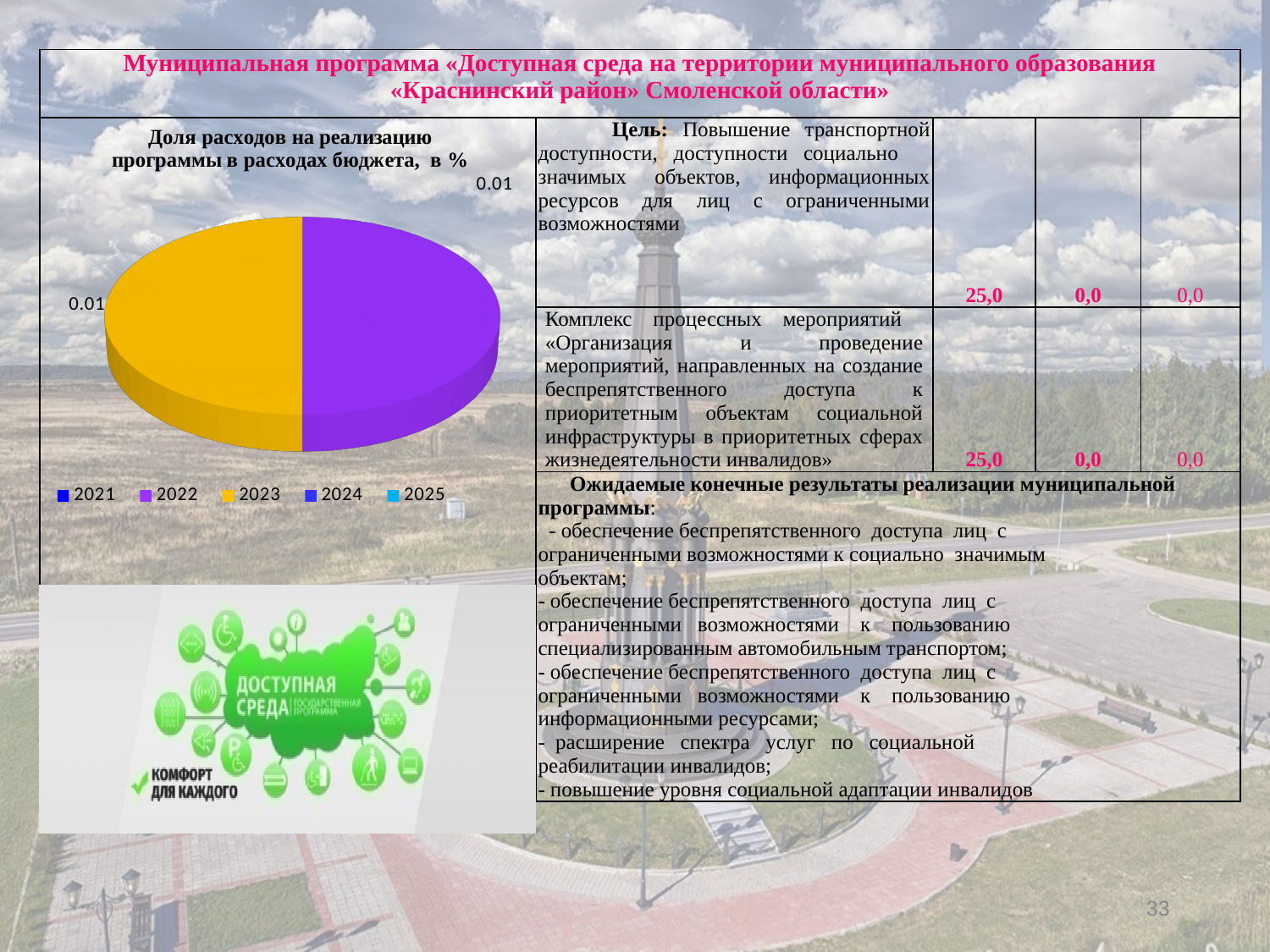
What value is labelled on the pie chart for 2022? 0.01 What value is labelled on the pie chart for 2023? 0.01 How many slices are visible in the pie chart? 2 Which years listed in the legend have no visible slice in the pie chart? 2021, 2024, 2025 What is the title of the pie chart? Доля расходов на реализацию программы в расходах бюджета, в % How many entries does the legend of the pie chart list? 5 What kind of chart is shown on the slide? pie chart Which colour represents 2023 in the pie chart? yellow